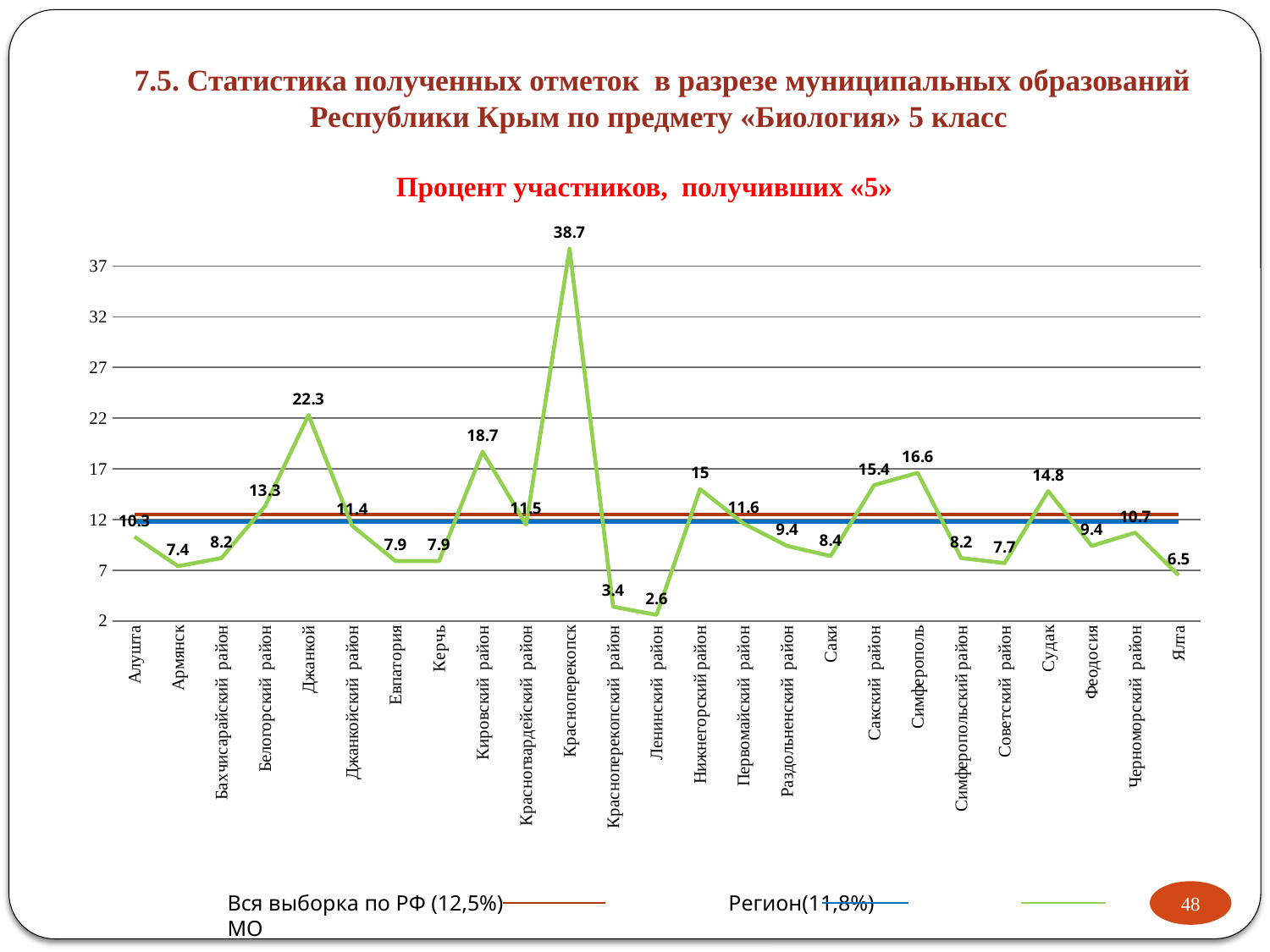
What is the percentage of participants who received a "5" in Красноперекопск? 38.7 What is the value for Симферополь? 16.6 What is the value for Джанкой? 22.3 Which has a higher value, Сакский район or Судак? Сакский район Which municipality has the highest percentage of participants who received a "5"? Красноперекопск What is the value for Ялта? 6.5 How many series does the legend list? 3 How many municipalities are shown on the x axis? 25 What value does the legend give for the series "Вся выборка по РФ"? 12,5% What is the difference between the values for Джанкой and Кировский район? 3.6 Which municipality has the lowest percentage of participants who received a "5"? Ленинский район What type of chart is shown on the slide? line chart